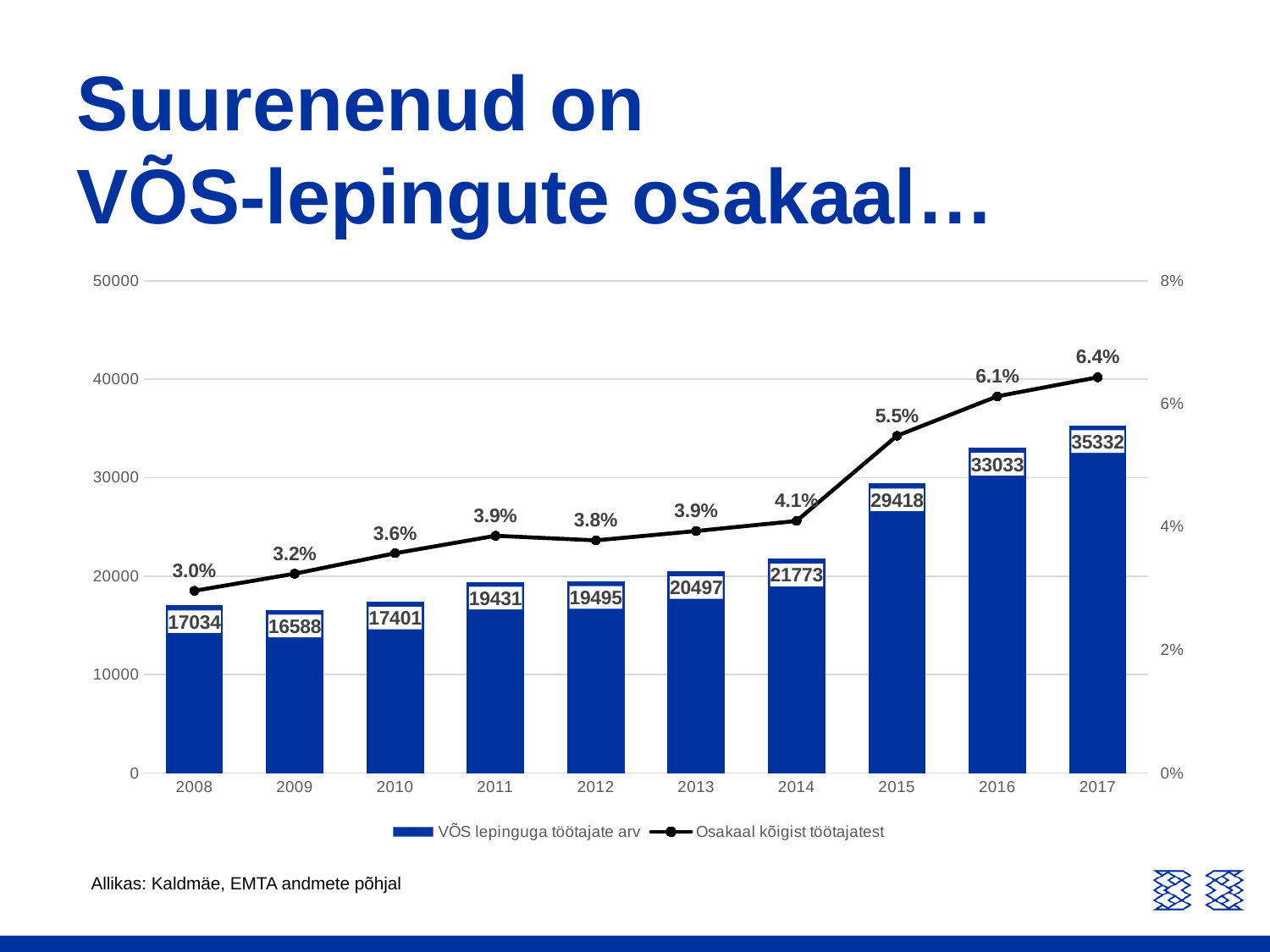
What kind of chart is shown on the slide? Combined bar and line chart Which is larger, the 'VÕS lepinguga töötajate arv' for 2011 or for 2013? 2013 How many series does the legend list? 2 What is the difference between the 'Osakaal kõigist töötajatest' values for 2017 and 2008? 3.4% What is the difference in 'VÕS lepinguga töötajate arv' between 2017 and 2016? 2299 Which year has the lowest 'VÕS lepinguga töötajate arv'? 2009 Does the 'Osakaal kõigist töötajatest' line generally rise or fall from 2008 to 2017? Rise Is the 'VÕS lepinguga töötajate arv' for 2014 greater or less than 20000? greater What is the 'Osakaal kõigist töötajatest' value for 2012? 3.8% How many years are shown on the x axis? 10 Which year has the highest 'VÕS lepinguga töötajate arv'? 2017 What is the value of 'VÕS lepinguga töötajate arv' for 2015? 29418